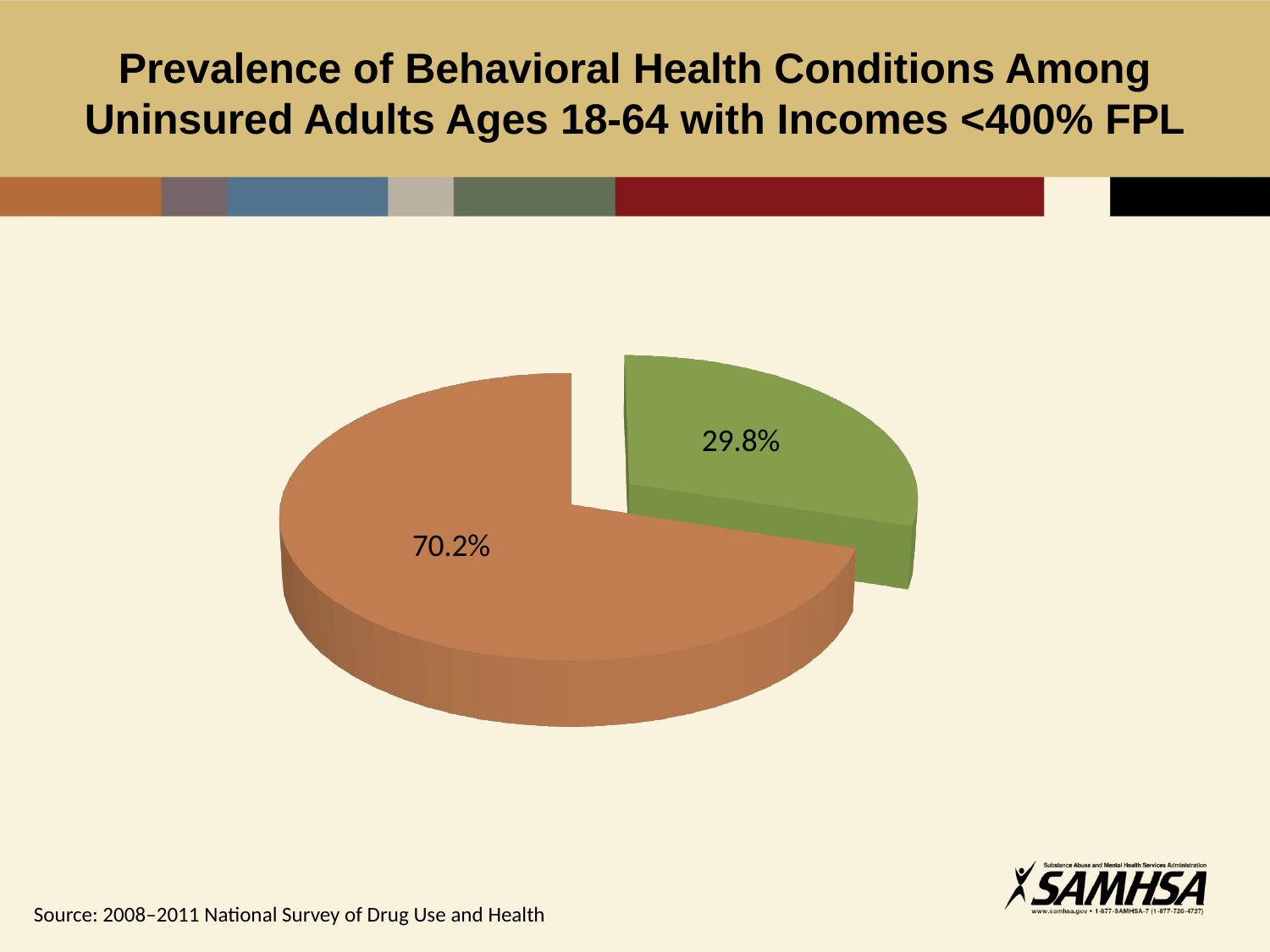
Which slice of the pie chart is the smallest? the green slice (29.8%) What share of the pie does the green slice represent? 29.8% Which slice of the pie chart is pulled out (exploded) from the rest of the pie? the green slice (29.8%) What is the title of the slide containing the pie chart? Prevalence of Behavioral Health Conditions Among Uninsured Adults Ages 18-64 with Incomes <400% FPL How many slices does the pie chart have? 2 What kind of chart is shown on the slide? pie chart What value is shown on the orange slice of the pie chart? 70.2% What is the total of the two slice values shown on the pie chart? 100% What value is shown on the green slice of the pie chart? 29.8% Which slice of the pie chart is the largest? the orange slice (70.2%) What is the difference in percentage points between the orange slice and the green slice? 40.4 Which is larger, the green slice or the orange slice? the orange slice